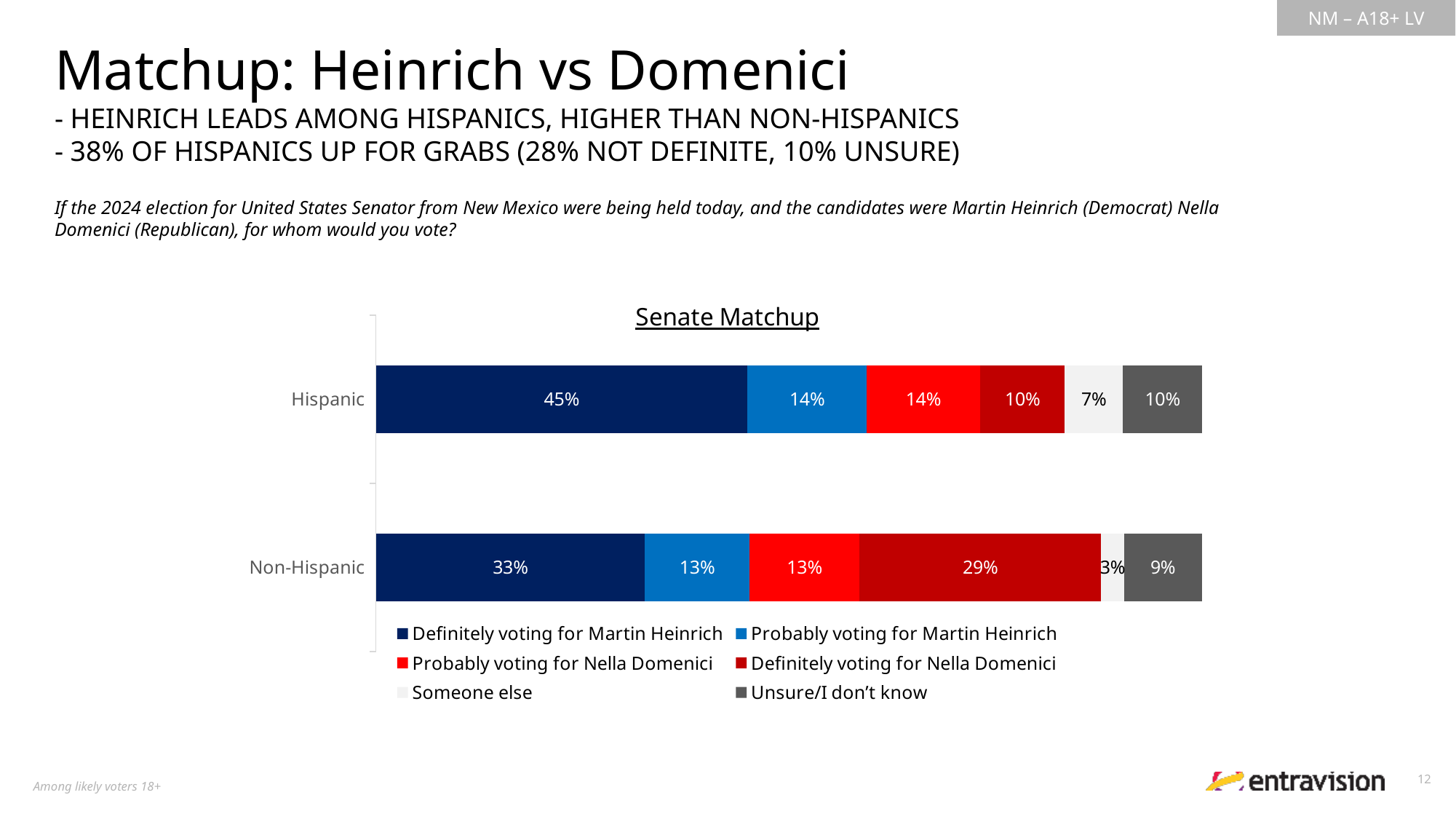
Which group has the higher share definitely voting for Martin Heinrich, Hispanic or Non-Hispanic? Hispanic What percentage of Non-Hispanic likely voters chose 'Someone else'? 3% How many series does the legend of the Senate Matchup chart list? 6 What percentage of Hispanic likely voters are unsure or don't know? 10% What is the difference between the Hispanic and Non-Hispanic shares definitely voting for Martin Heinrich? 12% How many groups (categories) are shown on the Senate Matchup chart? 2 What type of chart is the Senate Matchup chart? Stacked bar chart What percentage of Non-Hispanic likely voters are definitely voting for Nella Domenici? 29% What percentage of Hispanic likely voters are definitely voting for Martin Heinrich? 45% Which response category has the largest share among Non-Hispanic likely voters? Definitely voting for Martin Heinrich Which response category has the smallest share among Non-Hispanic likely voters? Someone else What is the difference between the Non-Hispanic and Hispanic shares definitely voting for Nella Domenici? 19%